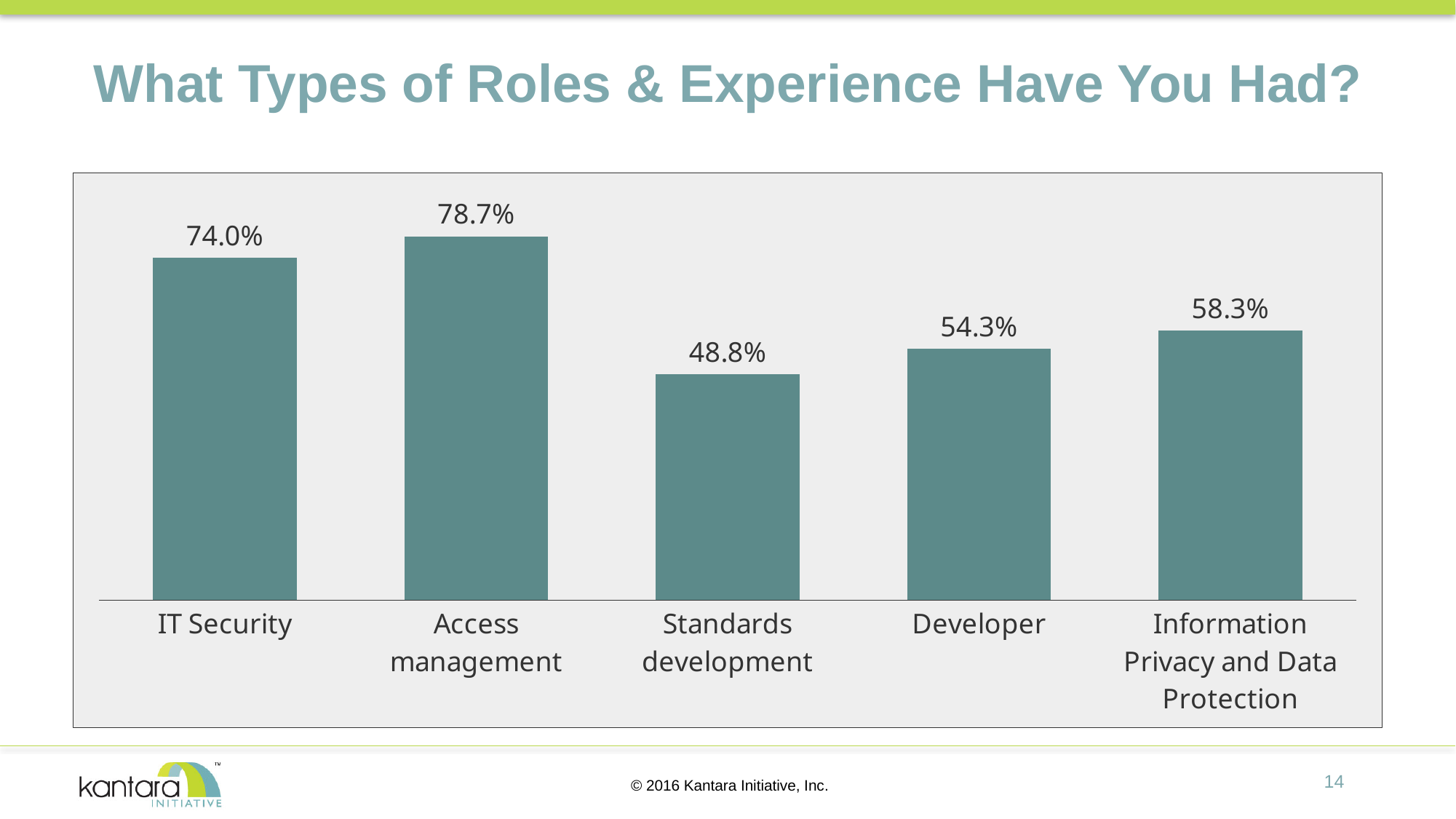
What is the title of the slide containing the chart? What Types of Roles & Experience Have You Had? How many categories are shown in the chart? 5 What is the difference between the values for Information Privacy and Data Protection and Developer? 4.0% What kind of chart is shown on the slide? Bar chart What is the value for Standards development? 48.8% What is the value for IT Security? 74.0% Which category has the lowest value? Standards development Which is larger, the value for Developer or the value for Standards development? Developer What is the difference between the values for Access management and IT Security? 4.7% What is the value for Information Privacy and Data Protection? 58.3% What is the value for Access management? 78.7% Which category has the highest value? Access management